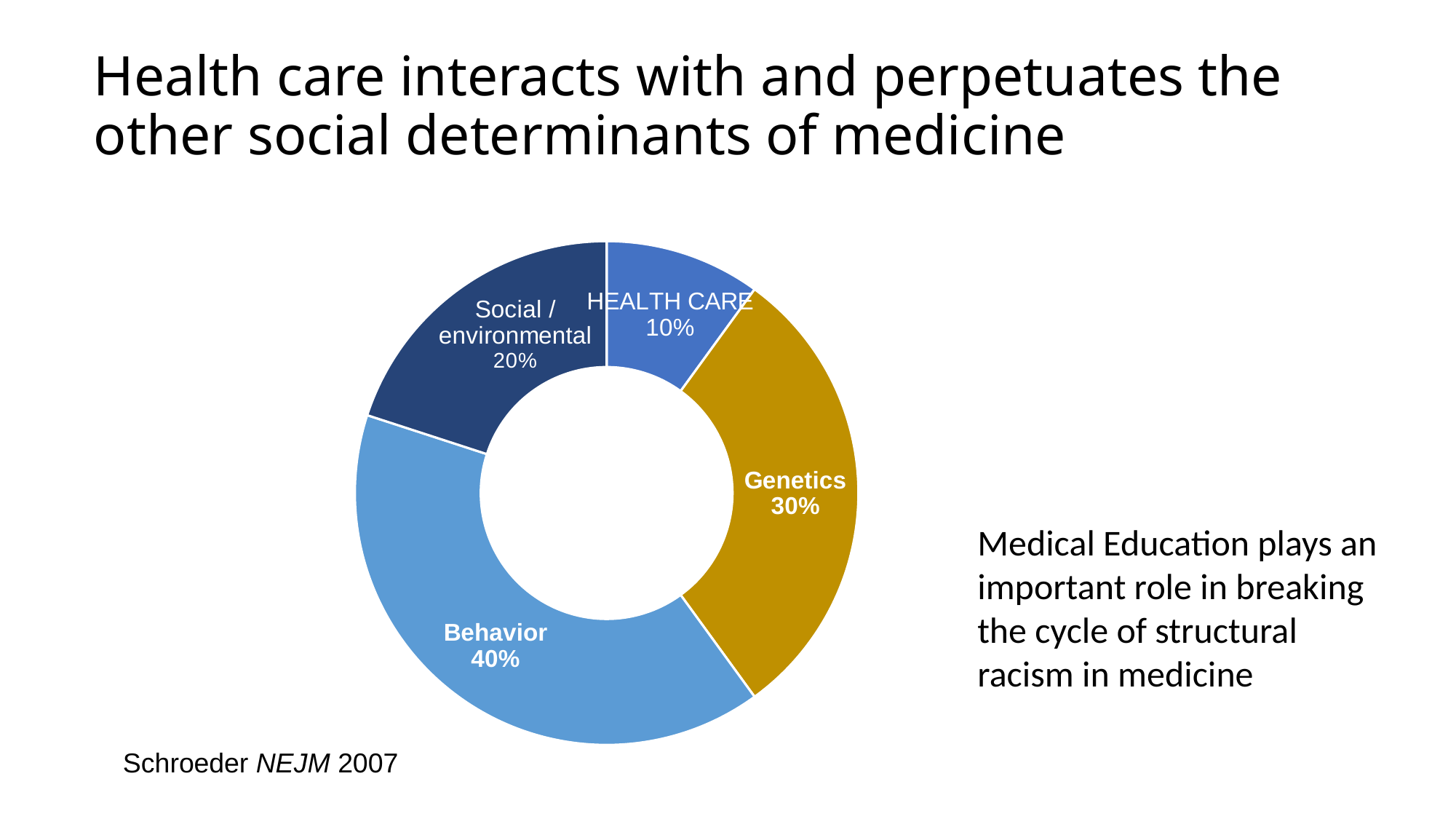
Which category has the largest share of the chart? Behavior How many categories are shown in the chart? 4 Which category has the smallest share of the chart? HEALTH CARE What is the combined share of Behavior and Genetics? 70% What colour is the Genetics segment of the chart? Gold (dark yellow) Which is larger, the share for Genetics or the share for Social / environmental? Genetics What kind of chart is shown on the slide? Doughnut (pie) chart What percentage is shown for Genetics? 30% What is the difference between the Behavior and Genetics percentages? 10% What percentage is shown for Behavior? 40% What percentage is shown for HEALTH CARE? 10% What percentage is shown for Social / environmental? 20%